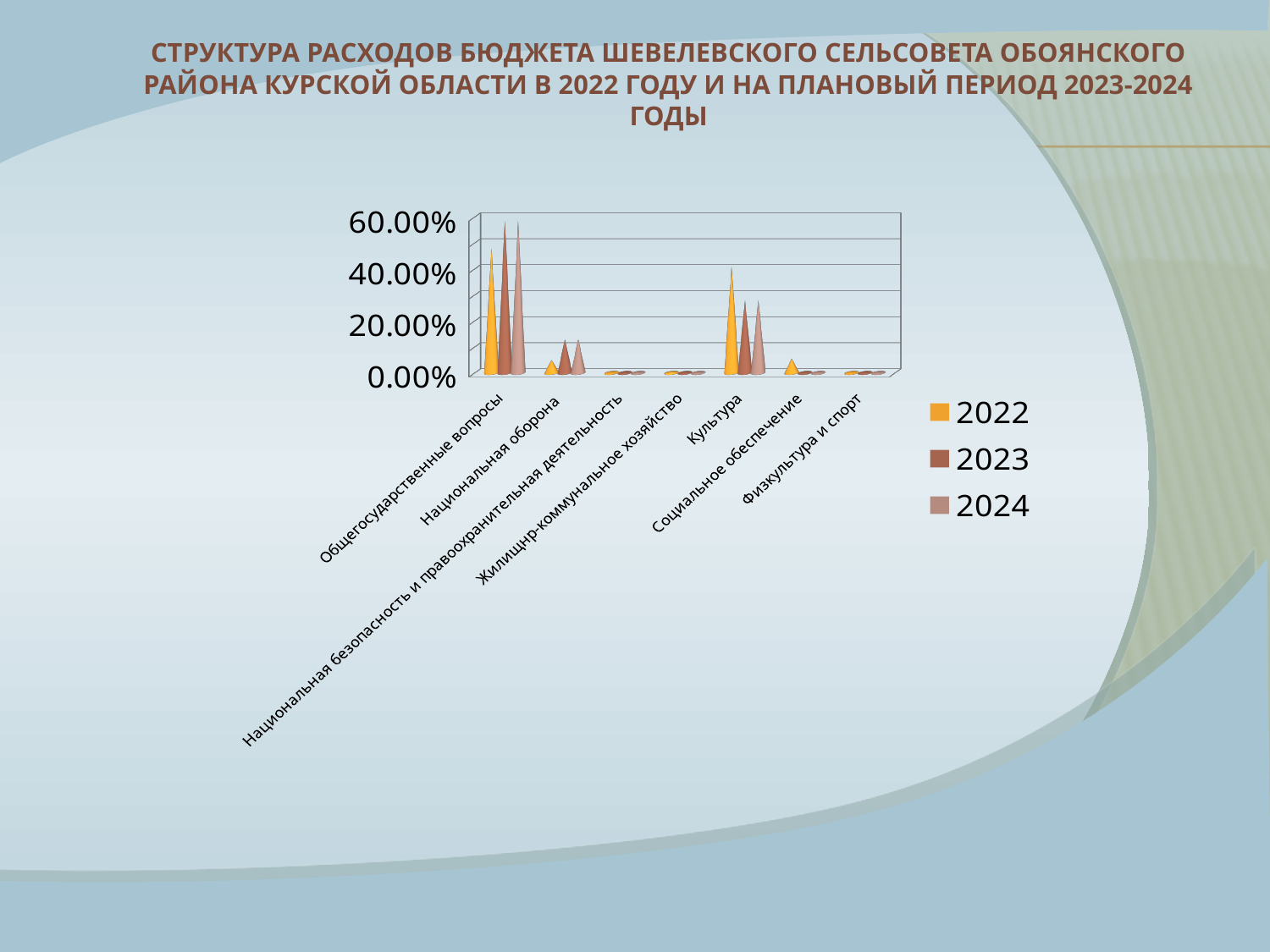
What kind of chart is shown on the slide? bar chart How many series does the chart legend list? 3 For Культура, which year has the larger value: 2022 or 2023? 2022 Is the value for Общегосударственные вопросы in 2023 greater or less than 40.00%? greater Which years are listed in the chart legend? 2022, 2023, 2024 Is the value for Социальное обеспечение in 2022 greater or less than 20.00%? less Which category has the highest value for the 2022 series? Общегосударственные вопросы Is the value for Культура in 2022 greater or less than 20.00%? greater Which category has the highest value for the 2023 series? Общегосударственные вопросы How many categories are shown on the x axis of the chart? 7 For the 2022 series, which is larger: Общегосударственные вопросы or Культура? Общегосударственные вопросы